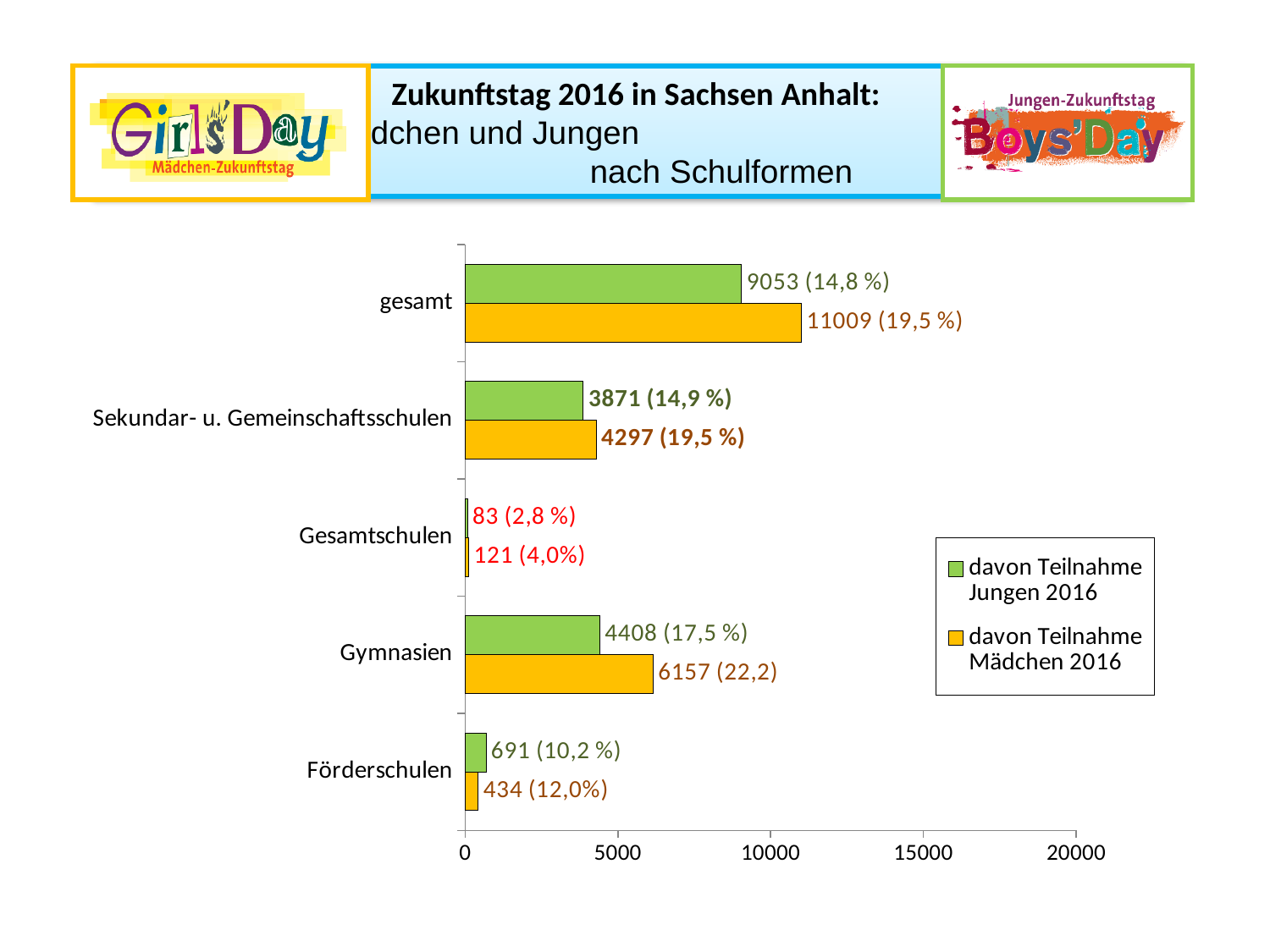
What is the data label for Jungen 2016 at Förderschulen? 691 (10,2 %) Which school type has the lowest Jungen 2016 participation? Gesamtschulen How many categories are shown on the vertical axis of the chart? 5 How many series does the legend list? 2 What is the difference between the Mädchen 2016 and Jungen 2016 participant numbers in the gesamt category? 1956 Is the Mädchen 2016 value for Sekundar- u. Gemeinschaftsschulen greater or less than 5000? less What is the data label for Jungen 2016 in the gesamt category? 9053 (14,8 %) What kind of chart is shown on the slide? bar chart Excluding the gesamt total, which school type has the highest Mädchen 2016 participation? Gymnasien What is the data label for Mädchen 2016 in the Gymnasien category? 6157 (22,2) At Förderschulen, which is larger: the Jungen 2016 or the Mädchen 2016 participant number? Jungen 2016 How many Mädchen participated in 2016 at Gesamtschulen according to the data label? 121